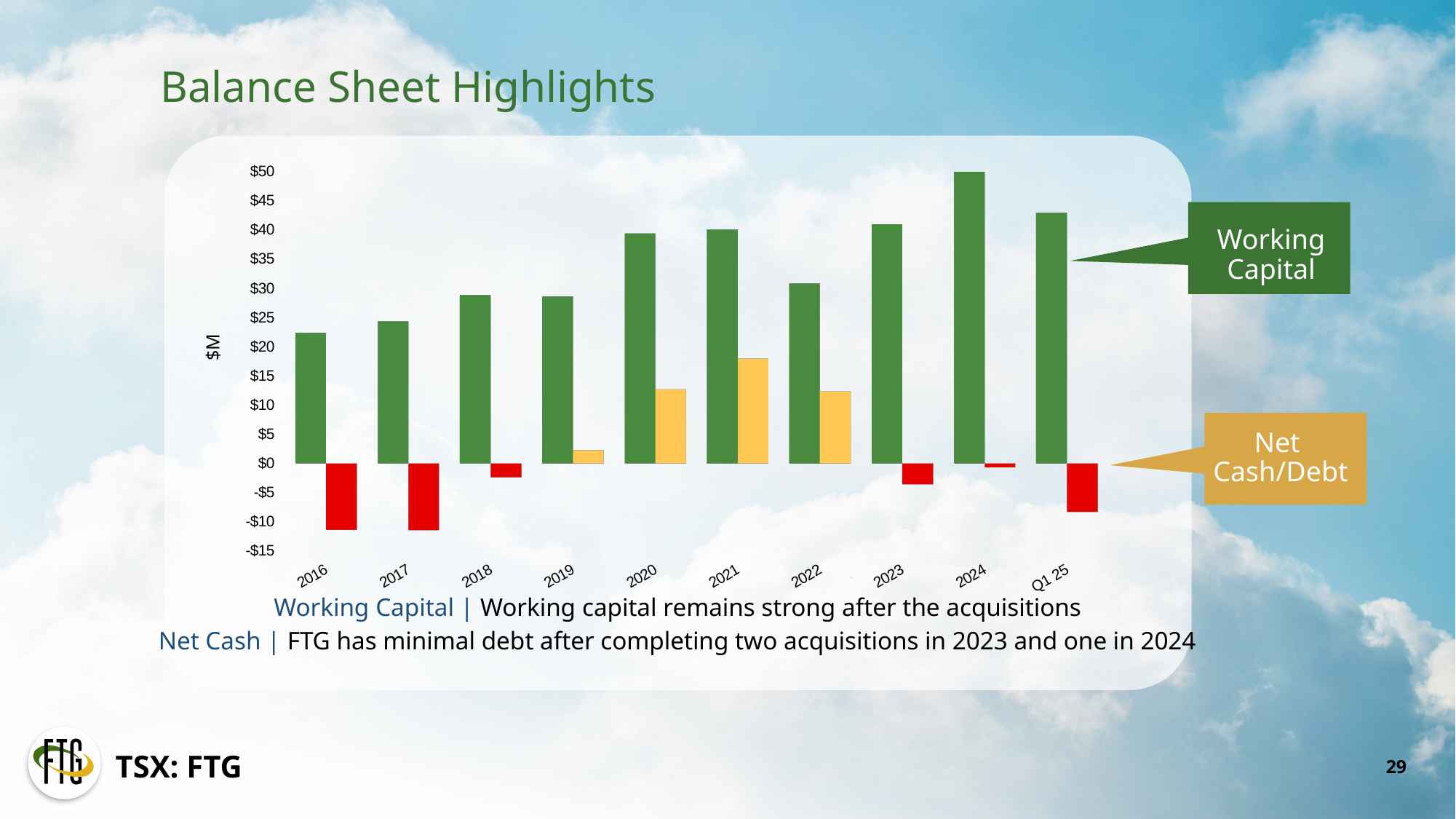
Is the Net Cash/Debt value for Q1 25 greater or less than -$5? less Which period has the highest Net Cash/Debt value? 2021 Which period has the lowest Working Capital? 2016 Which period has the highest Working Capital? 2024 What kind of chart is shown on the slide? bar chart Is the Working Capital for 2024 greater or less than $45? greater Is the Net Cash/Debt value for 2021 greater or less than $15? greater How many periods are shown on the x axis of the chart? 10 What unit is shown on the y axis of the chart? $M Does Working Capital generally rise or fall from 2016 to 2024? rise Which is larger, the Working Capital for 2022 or for 2023? 2023